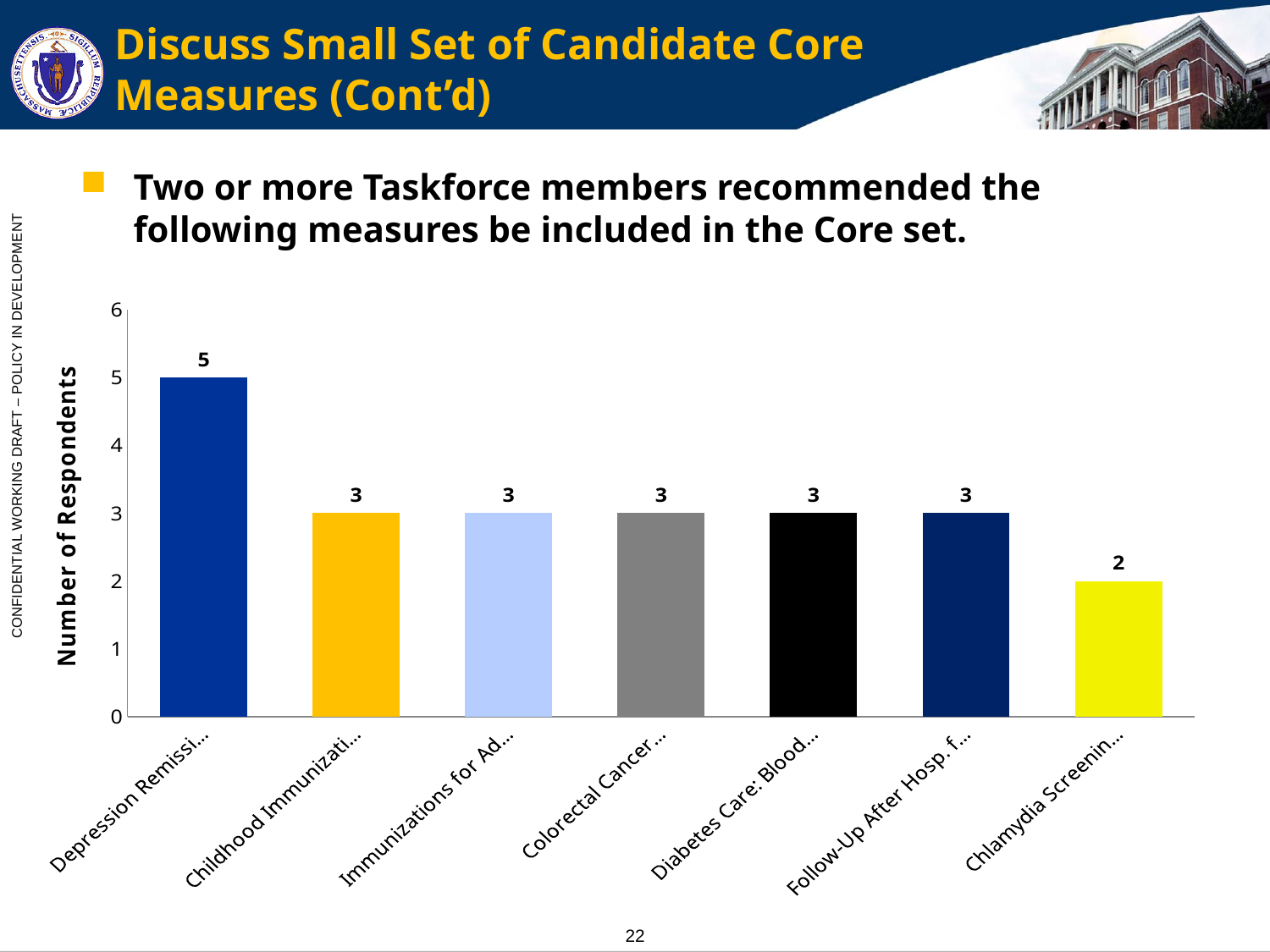
Which measure has the highest number of respondents? Depression Remissi… Which measure has the lowest number of respondents? Chlamydia Screenin… What kind of chart is shown on the slide? Bar chart How many measures (bars) are shown in the chart? 7 What is the value for the bar labelled 'Chlamydia Screenin…'? 2 Is the value for 'Depression Remissi…' greater or less than 4? greater What is the difference in respondents between the 'Depression Remissi…' bar and the 'Chlamydia Screenin…' bar? 3 How many bars have a value of 3? 5 How many respondents recommended the measure labelled 'Depression Remissi…'? 5 What is the label on the vertical axis of the chart? Number of Respondents What is the value for the bar labelled 'Colorectal Cancer…'? 3 Which has more respondents, 'Childhood Immunizati…' or 'Chlamydia Screenin…'? Childhood Immunizati…